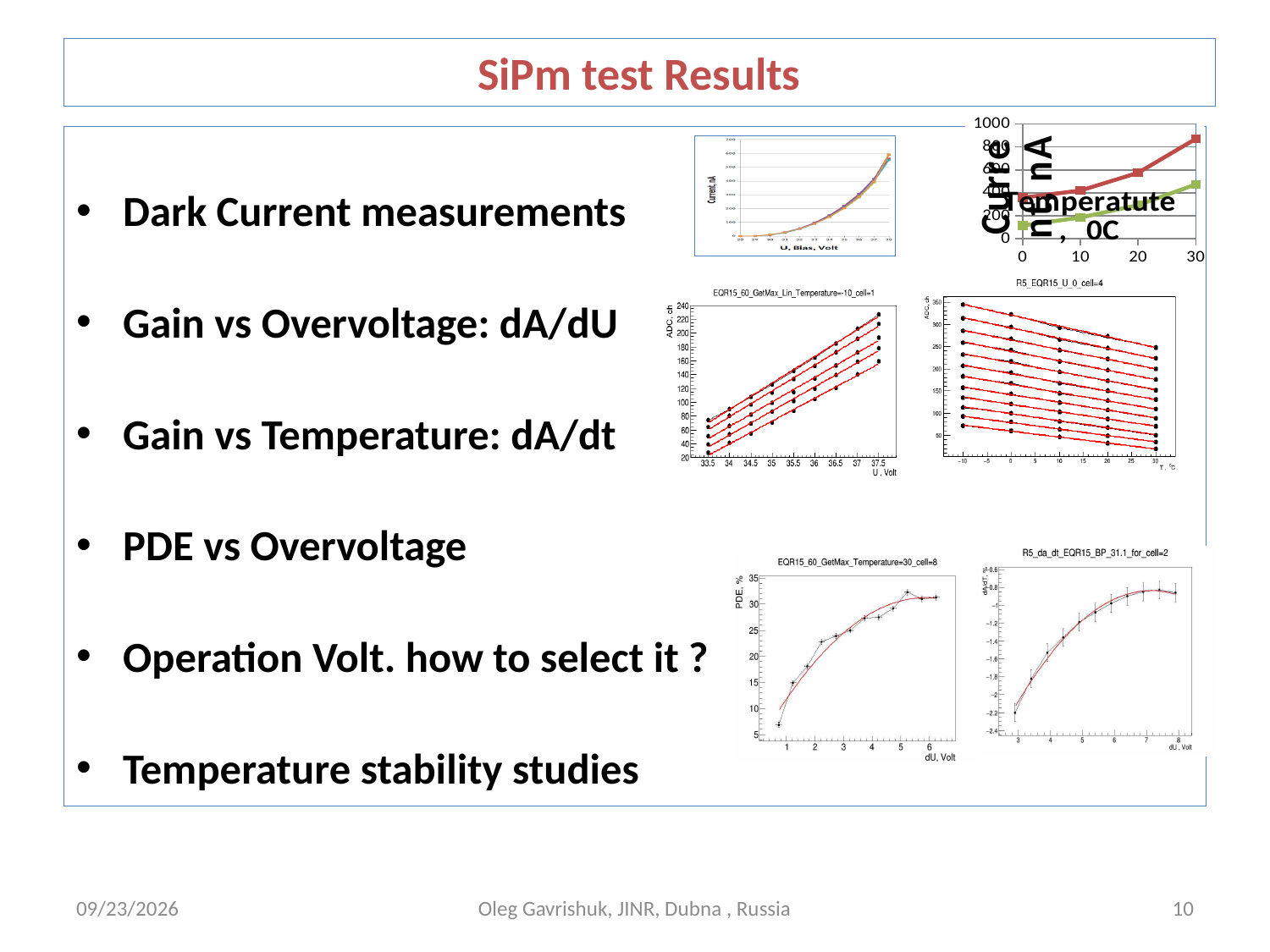
In the chart titled 'R5_EQR15_U_0_cell=4' (ADC, ch vs T, °C), do the values rise or fall as temperature increases? fall What kind of chart is the top-right chart with the x axis running from 0 to 30? line chart In the chart titled 'EQR15_60_GetMax_Lin_Temperature=-10_cell=1' (ADC, ch vs U, Volt), do the values rise or fall as U increases? rise In the chart titled 'EQR15_60_GetMax_Temperature=30_cell=8' (PDE, % vs dU, Volt), is the PDE value at dU = 6 greater or less than 25? greater In the chart titled 'EQR15_60_GetMax_Temperature=30_cell=8', is the PDE value at dU = 1 greater or less than 10? less In the top-right chart (x axis 0 to 30), do the values rise or fall as the x axis increases? rise In the top-right chart (x axis 0 to 30), is the value of the red line at x = 30 greater or less than 600? greater In the top-right chart (x axis 0 to 30), how many plotted lines are there? 2 What is the x-axis label of the chart titled 'EQR15_60_GetMax_Temperature=30_cell=8'? dU, Volt In the top-right chart (x axis 0 to 30), which line is higher at x = 30, the red line or the green line? red line